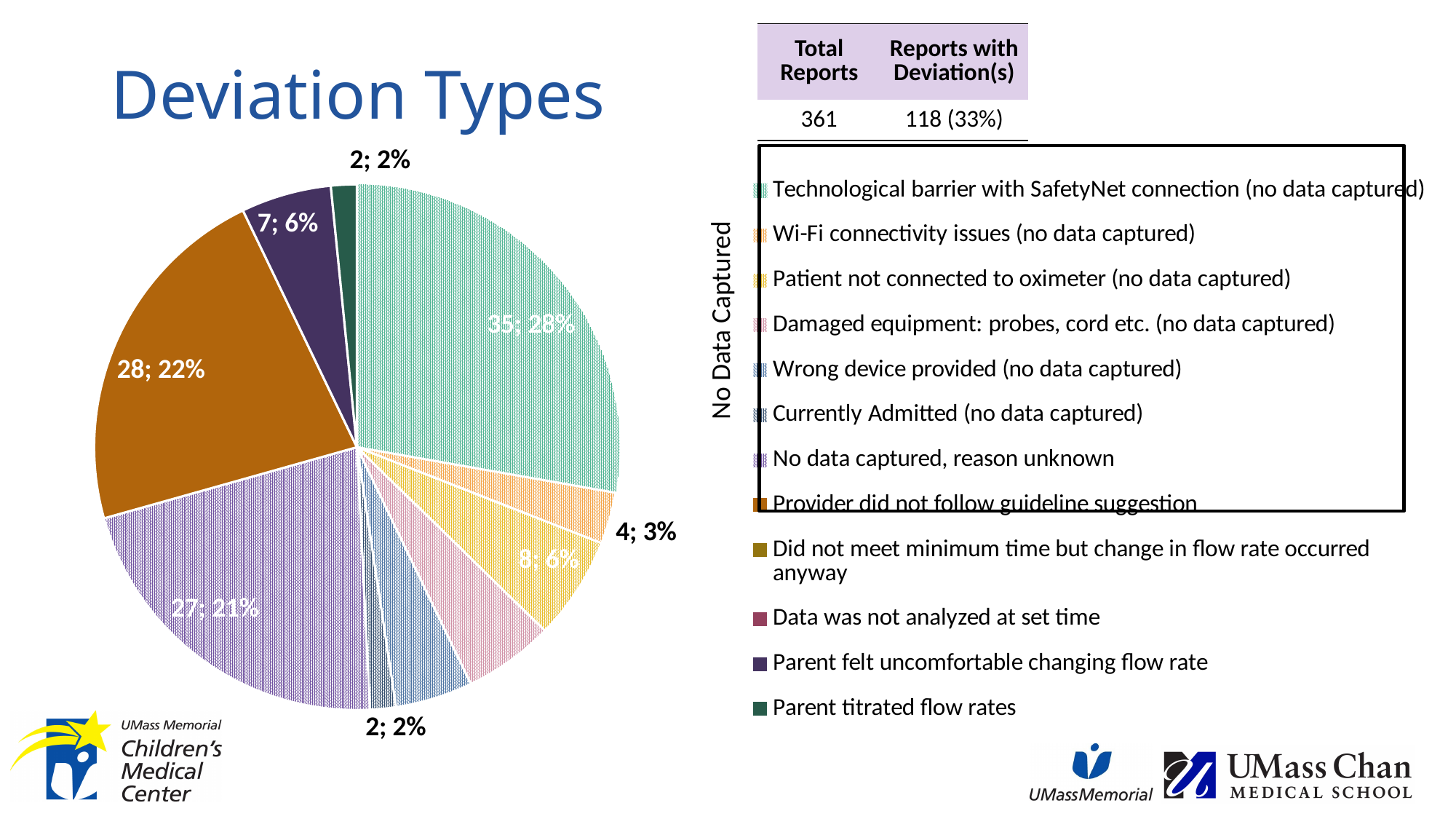
What count and percentage are shown for 'Parent felt uncomfortable changing flow rate'? 7; 6% Which is larger: the slice for 'Technological barrier with SafetyNet connection (no data captured)' or the slice for 'Provider did not follow guideline suggestion'? Technological barrier with SafetyNet connection (no data captured) What is the difference in count between 'Provider did not follow guideline suggestion' and 'No data captured, reason unknown'? 1 Which deviation type has the largest slice of the pie? Technological barrier with SafetyNet connection (no data captured) What count and percentage are shown for 'Technological barrier with SafetyNet connection (no data captured)'? 35; 28% What count and percentage are shown for 'No data captured, reason unknown'? 27; 21% What share of the pie does 'Patient not connected to oximeter (no data captured)' represent? 6% What count and percentage are shown for 'Provider did not follow guideline suggestion'? 28; 22% What count and percentage are shown for 'Wi-Fi connectivity issues (no data captured)'? 4; 3% What kind of chart is shown on the slide? pie chart How many categories does the legend of the pie chart list? 12 What is the title of the chart? Deviation Types